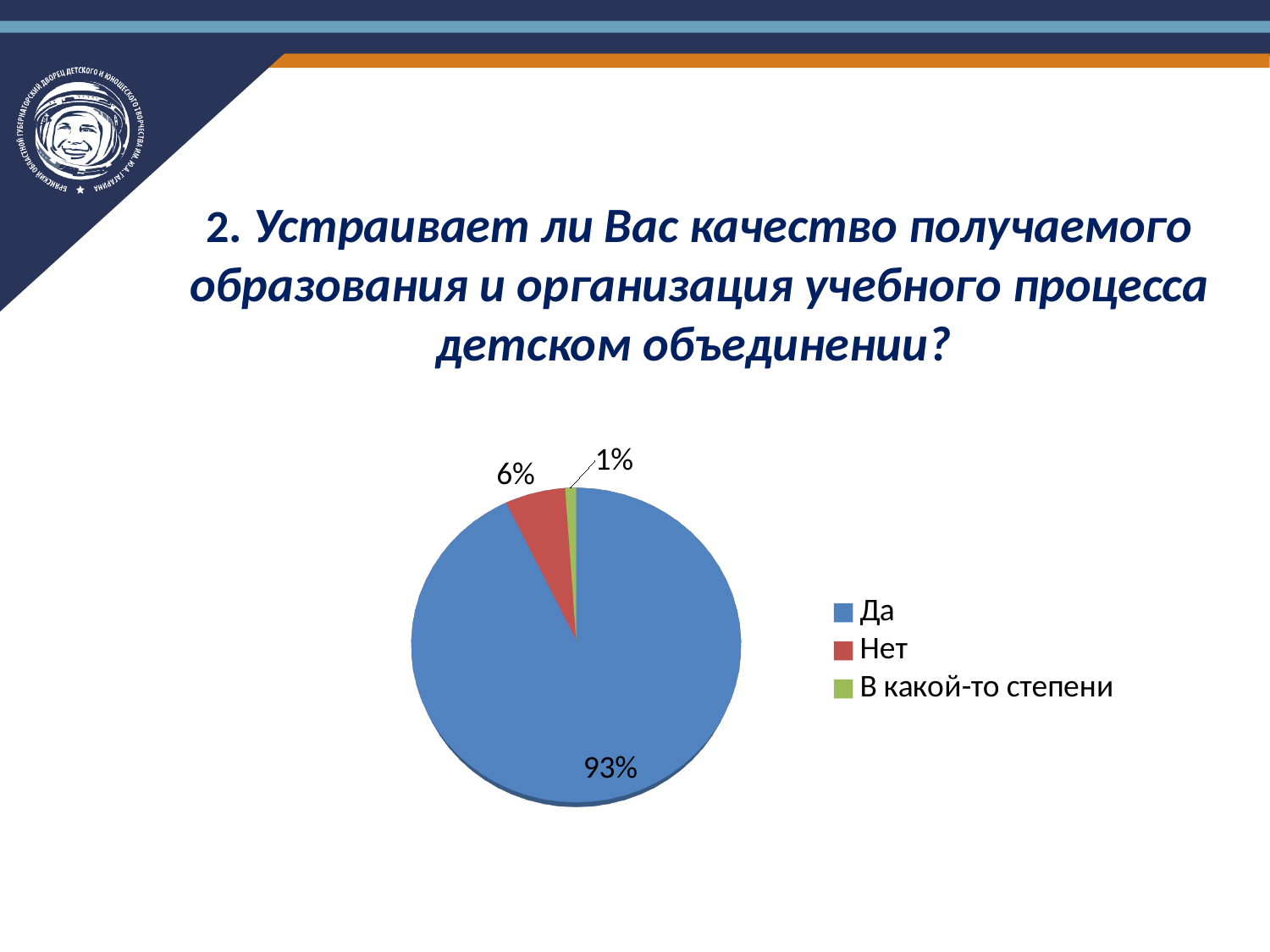
What kind of chart is shown on the slide? Pie chart How many categories are shown in the pie chart? 3 What colour is the "Нет" slice in the pie chart? Red What share of the pie does the "В какой-то степени" slice represent? 1% What share of the pie does the "Нет" slice represent? 6% What is the difference between the "Да" share and the "Нет" share? 87% Which category has the smallest slice of the pie? В какой-то степени What share of the pie does the "Да" slice represent? 93% Which category has the largest slice of the pie? Да Which is larger, the "Нет" slice or the "В какой-то степени" slice? Нет What is the difference between the "Нет" share and the "В какой-то степени" share? 5% Which legend entry is shown in green? В какой-то степени